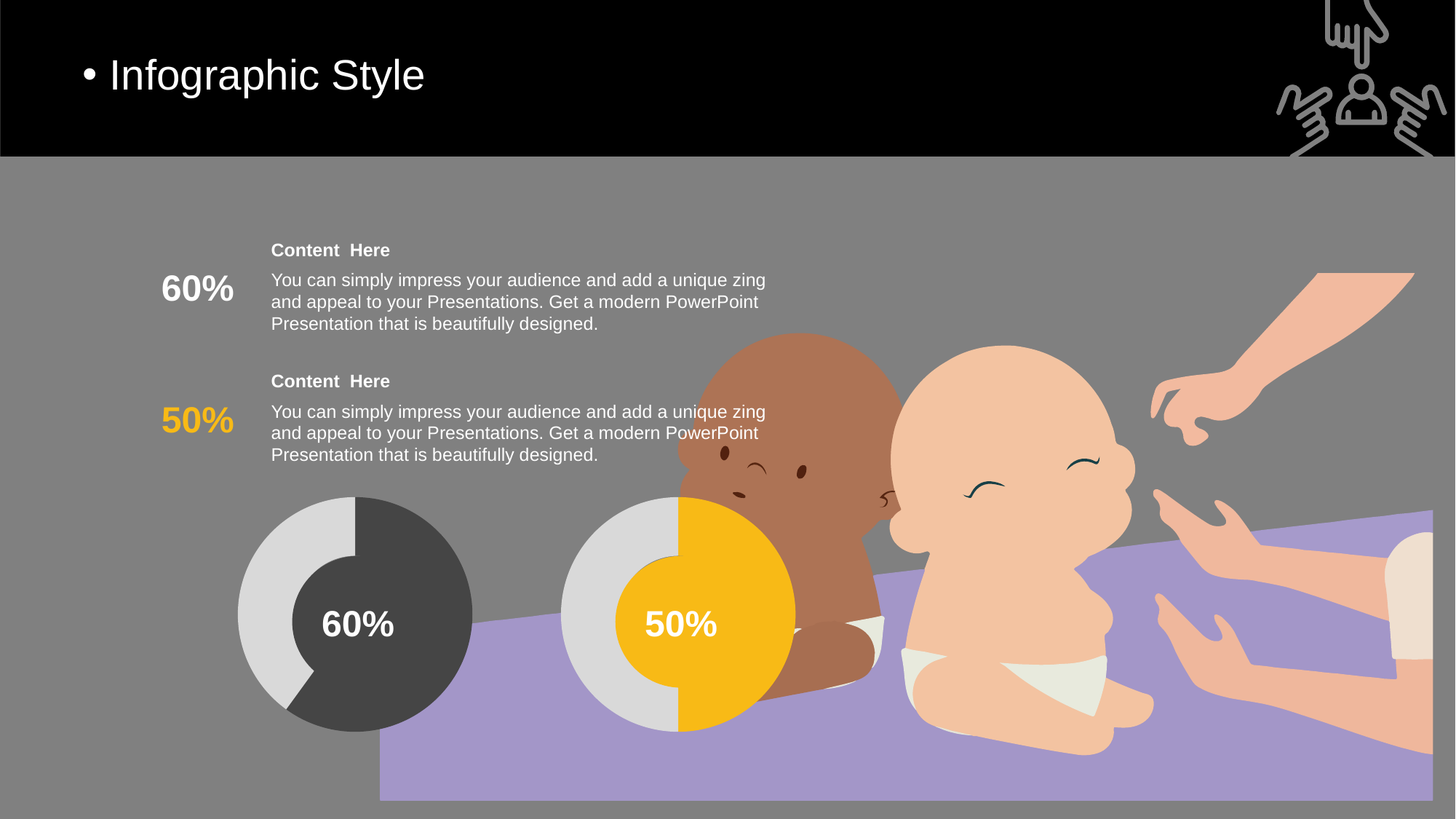
What kind of chart is used for the two percentage graphics on the slide? Doughnut chart What colour is the filled portion of the left doughnut chart? Dark grey Which doughnut chart shows the larger value, the left one or the right one? The left one Is the value shown in the left doughnut chart greater or less than 50%? greater What share of the right doughnut chart is filled with the yellow colour? 50% What colour is the filled portion of the right doughnut chart? Yellow How many doughnut charts are on the slide? 2 What share of the left doughnut chart is filled with the dark grey colour? 60% What is the difference between the value in the left doughnut chart and the value in the right doughnut chart? 10 percentage points Which doughnut chart shows the smallest value? The right one (50%) What value is shown in the centre of the left doughnut chart? 60% What value is shown in the centre of the right doughnut chart? 50%